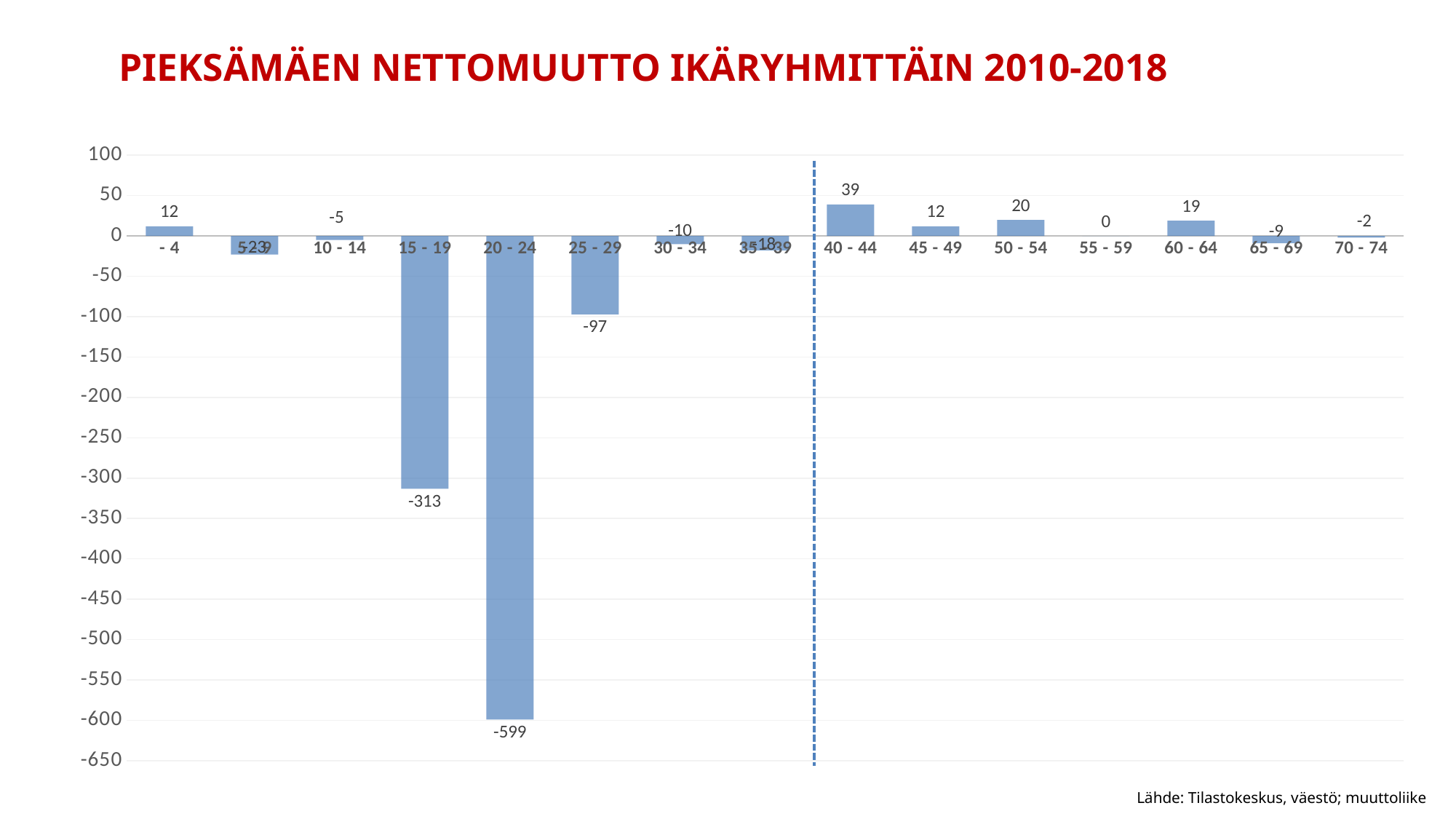
Which age group has the highest value? 40 - 44 How many age groups are shown on the x axis? 15 What is the difference between the values for the 15 - 19 and 20 - 24 age groups? 286 What is the value shown for the 15 - 19 age group? -313 What is the value shown for the 40 - 44 age group? 39 What is the value shown for the 55 - 59 age group? 0 Which has the larger value, the 50 - 54 age group or the 60 - 64 age group? 50 - 54 What type of chart is shown on the slide? Bar chart What is the net migration value for the 20 - 24 age group? -599 What is the title of the chart? PIEKSÄMÄEN NETTOMUUTTO IKÄRYHMITTÄIN 2010-2018 What is the value shown for the 25 - 29 age group? -97 Which age group has the lowest value? 20 - 24